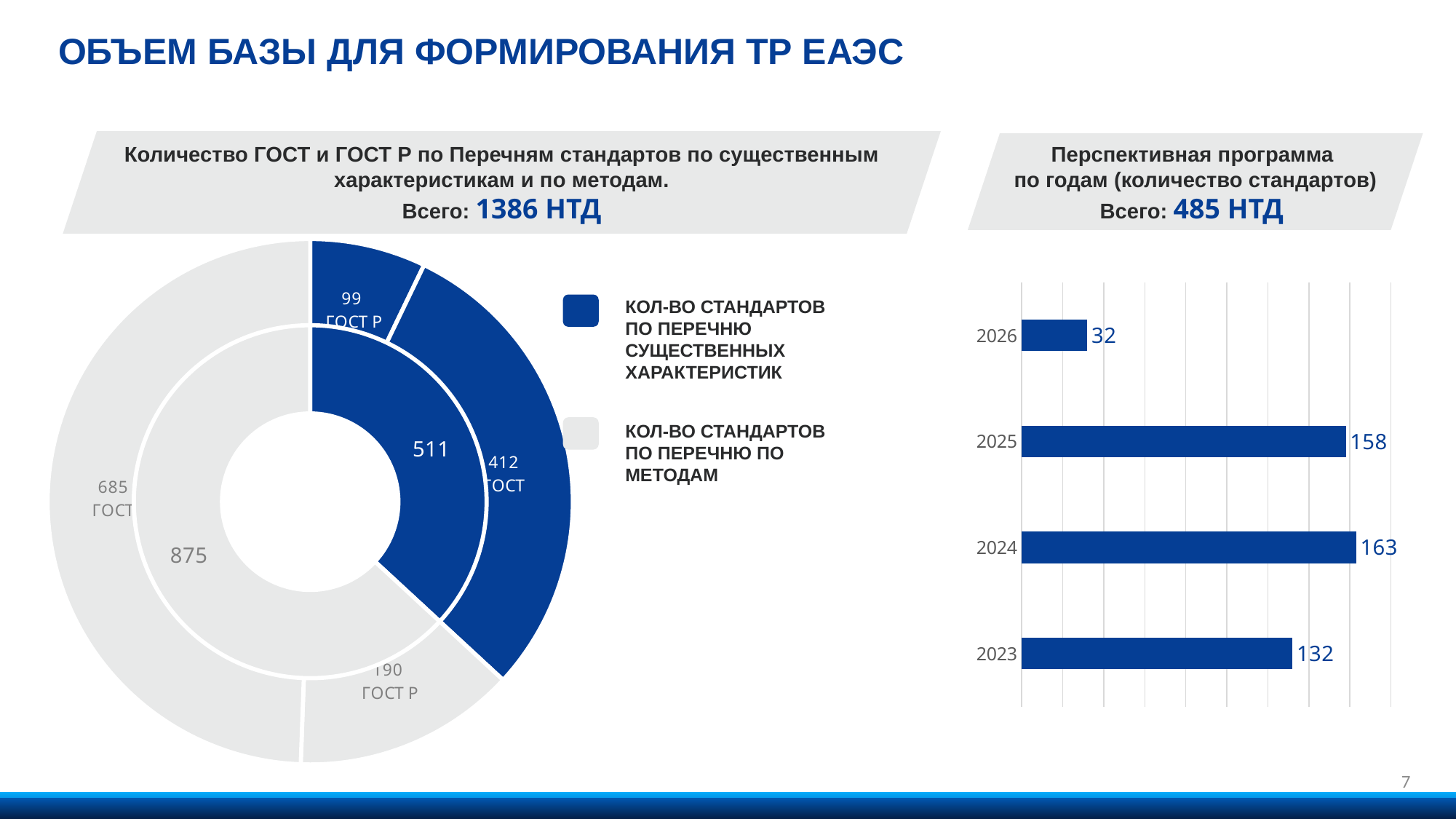
In the bar chart on the right, what is the value for 2026? 32 In the donut chart on the left, what is the value of the grey inner segment (standards by the list of methods)? 875 In the bar chart on the right, which year has the lowest value? 2026 What kind of chart is shown on the right side of the slide? Bar chart In the bar chart on the right, which year has the highest value? 2024 In the bar chart on the right (Перспективная программа по годам), what is the value for 2024? 163 How many entries does the legend of the donut chart on the left list? 2 In the bar chart on the right, what is the difference between the values for 2025 and 2023? 26 In the donut chart on the left, what is the value labelled ГОСТ in the blue outer ring? 412 In the donut chart on the left, what is the value of the blue inner segment (standards by the list of essential characteristics)? 511 How many years are shown in the bar chart on the right? 4 In the bar chart on the right, which is larger: the value for 2025 or the value for 2023? 2025